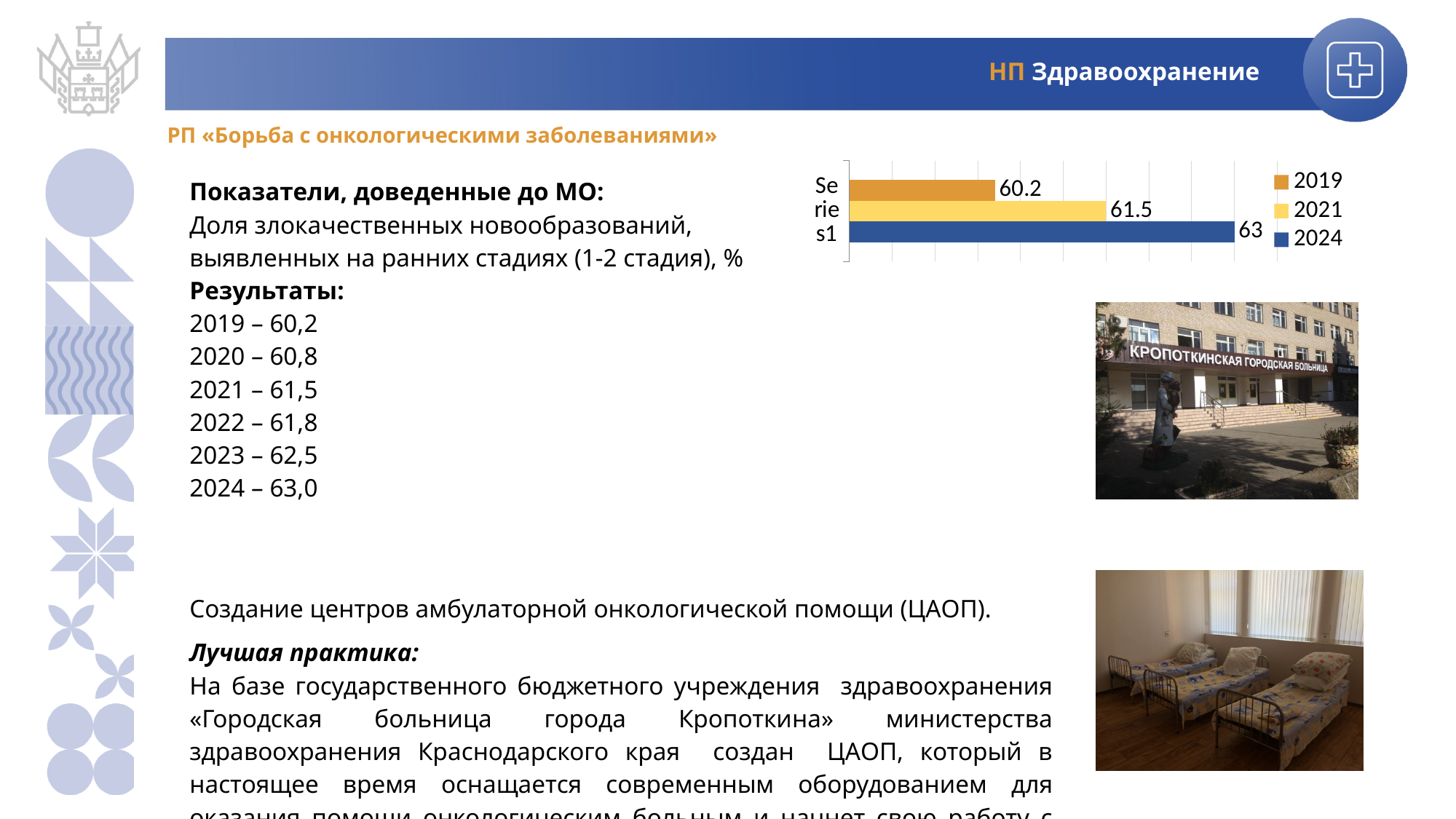
Which series has the lowest value in the chart? 2019 What is the difference between the 2021 value and the 2019 value in the chart? 1.3 What is the difference between the 2024 value and the 2019 value in the chart? 2.8 How many bars are plotted in the chart? 3 Which series has the highest value in the chart? 2024 What kind of chart is shown on the slide? Bar chart What is the value of the 2021 bar in the chart? 61.5 Which is larger in the chart, the 2021 value or the 2024 value? 2024 What is the value of the 2024 bar in the chart? 63 What colour is the 2024 bar in the chart? Blue What is the value of the 2019 bar in the chart? 60.2 How many series does the chart legend list? 3